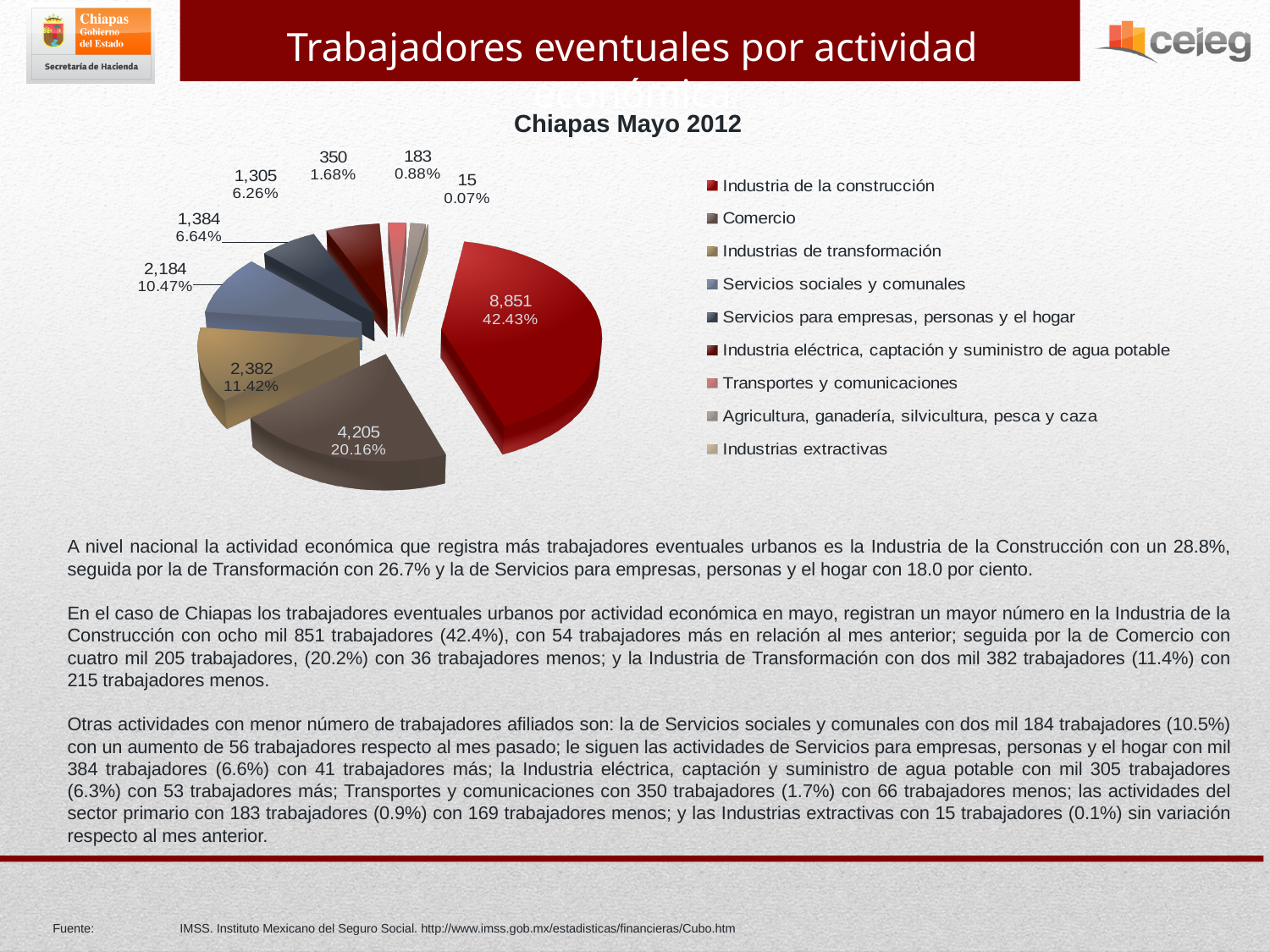
How many slices does the pie chart have? 9 Which category has the smallest slice of the pie? Industrias extractivas What percentage share does Industrias de transformación have? 11.42% What is the difference in workers between Industria de la construcción and Comercio? 4,646 What kind of chart is shown on the slide? pie chart What is the value shown for Comercio? 4,205 What percentage share of the pie does Industria de la construcción have? 42.43% What is the number of workers shown for Industria de la construcción? 8,851 What is the subtitle shown above the pie chart? Chiapas Mayo 2012 How many entries does the legend of the pie chart list? 9 Which is larger, the value for Servicios sociales y comunales or the value for Servicios para empresas, personas y el hogar? Servicios sociales y comunales Which category has the largest slice of the pie? Industria de la construcción